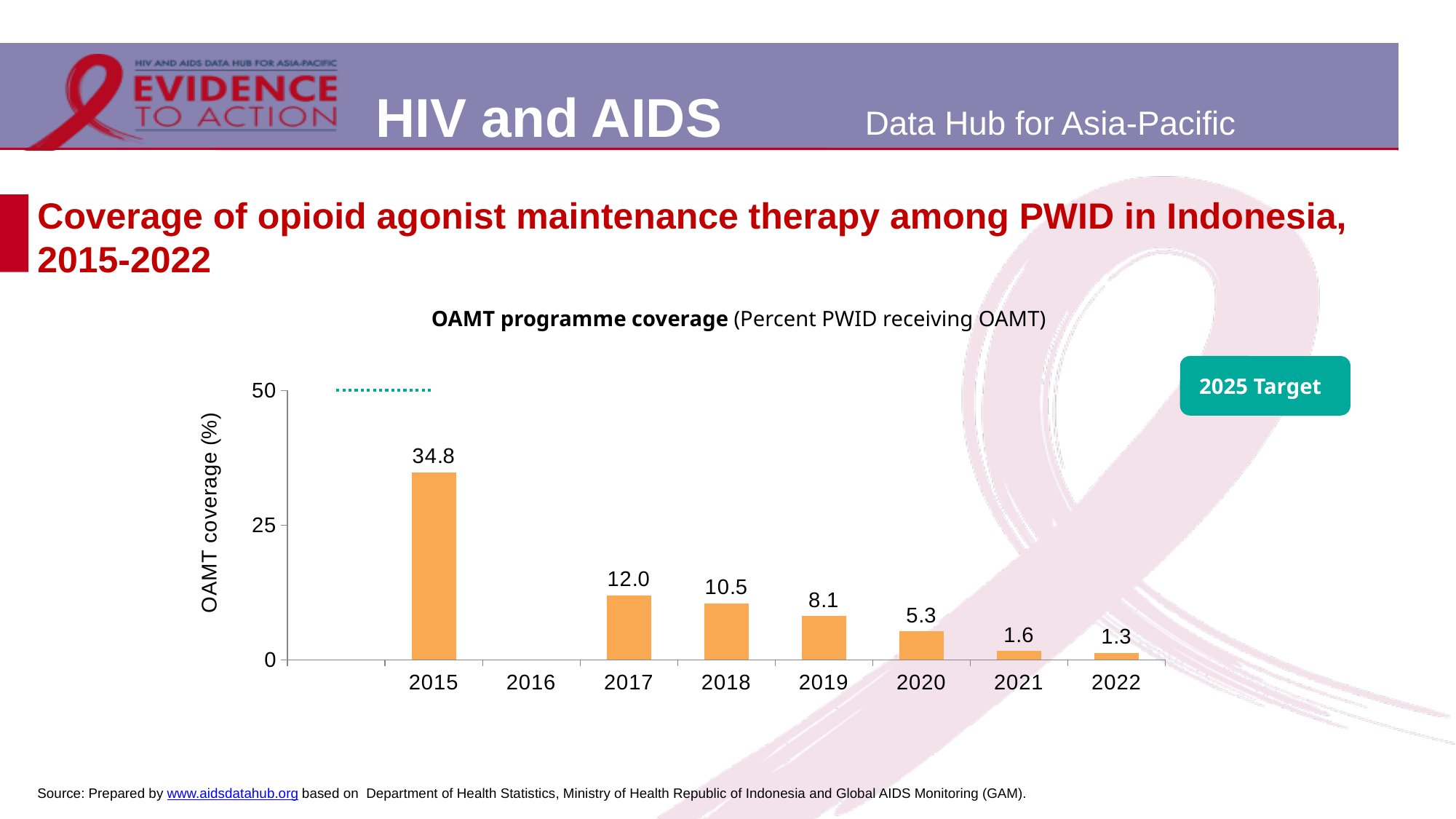
Do the OAMT coverage values rise or fall from 2017 to 2022? Fall Which year has the highest OAMT coverage? 2015 What kind of chart is shown on the slide? Bar chart What is the OAMT coverage value for 2019? 8.1 What is the OAMT coverage value for 2015? 34.8 What does the dotted line at 50 on the chart represent? 2025 Target Is the value for 2015 greater or less than 25? greater How many years are shown on the x axis? 8 What is the OAMT coverage value for 2022? 1.3 Which year with a plotted bar has the lowest OAMT coverage? 2022 Which year has a higher OAMT coverage, 2020 or 2021? 2020 What is the difference between the OAMT coverage in 2017 and 2018? 1.5